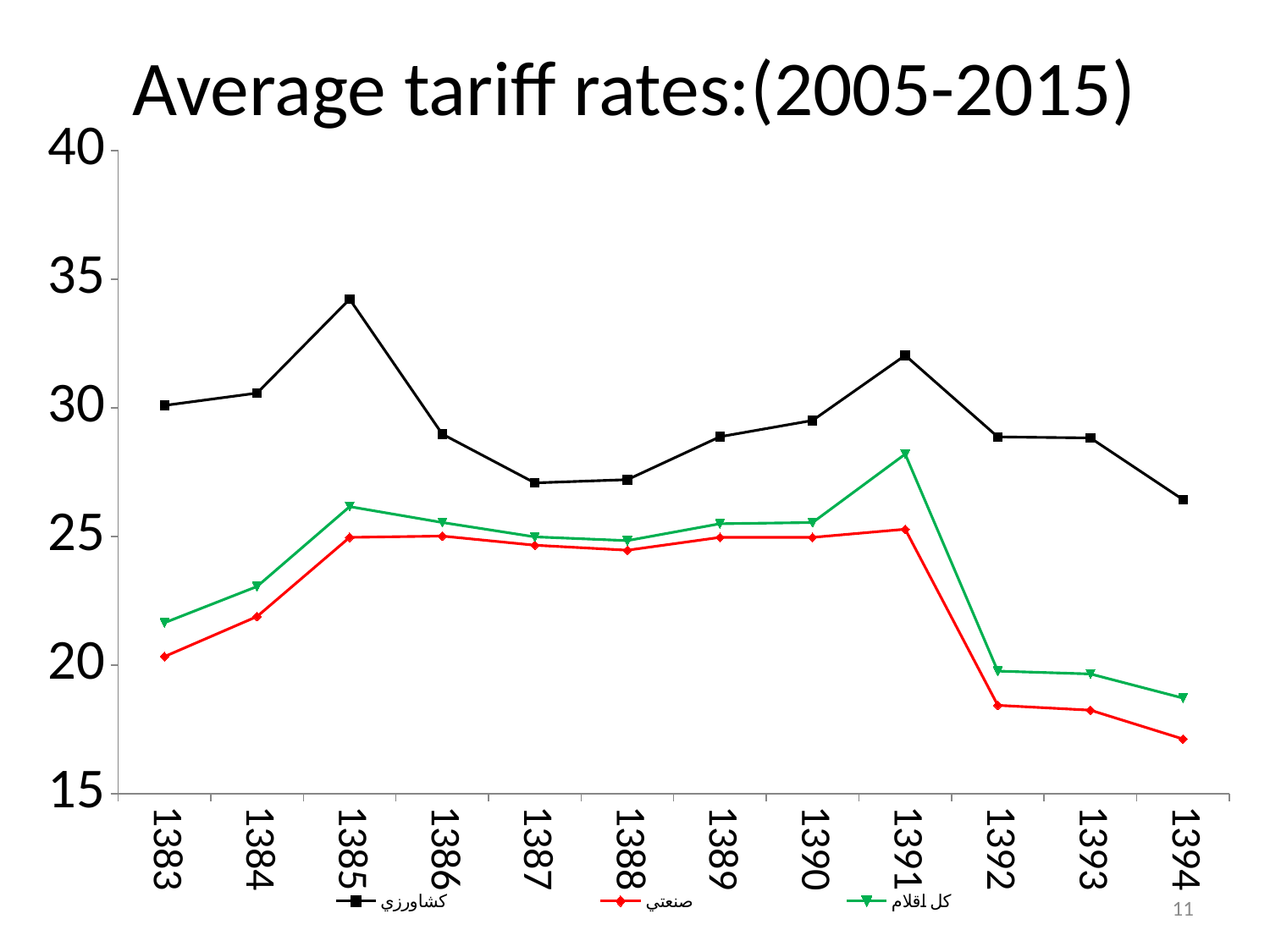
How many series does the legend list? 3 Does the کل اقلام (green) series rise or fall from 1391 to 1394? fall What kind of chart is shown on the slide? line chart Is the value of the کشاورزی (black) series in 1385 greater or less than 30? greater How many years are plotted along the x axis? 12 In 1383, which series has the larger value: کل اقلام (green) or صنعتی (red)? کل اقلام (green) In which year does the کل اقلام (green) series reach its highest value? 1391 In which year does the کشاورزی (black) series reach its lowest value? 1394 Is the value of the کل اقلام (green) series in 1391 greater or less than 25? greater In which year does the کشاورزی (black) series reach its highest value? 1385 Is the value of the صنعتی (red) series in 1392 greater or less than 20? less In which year does the صنعتی (red) series reach its lowest value? 1394